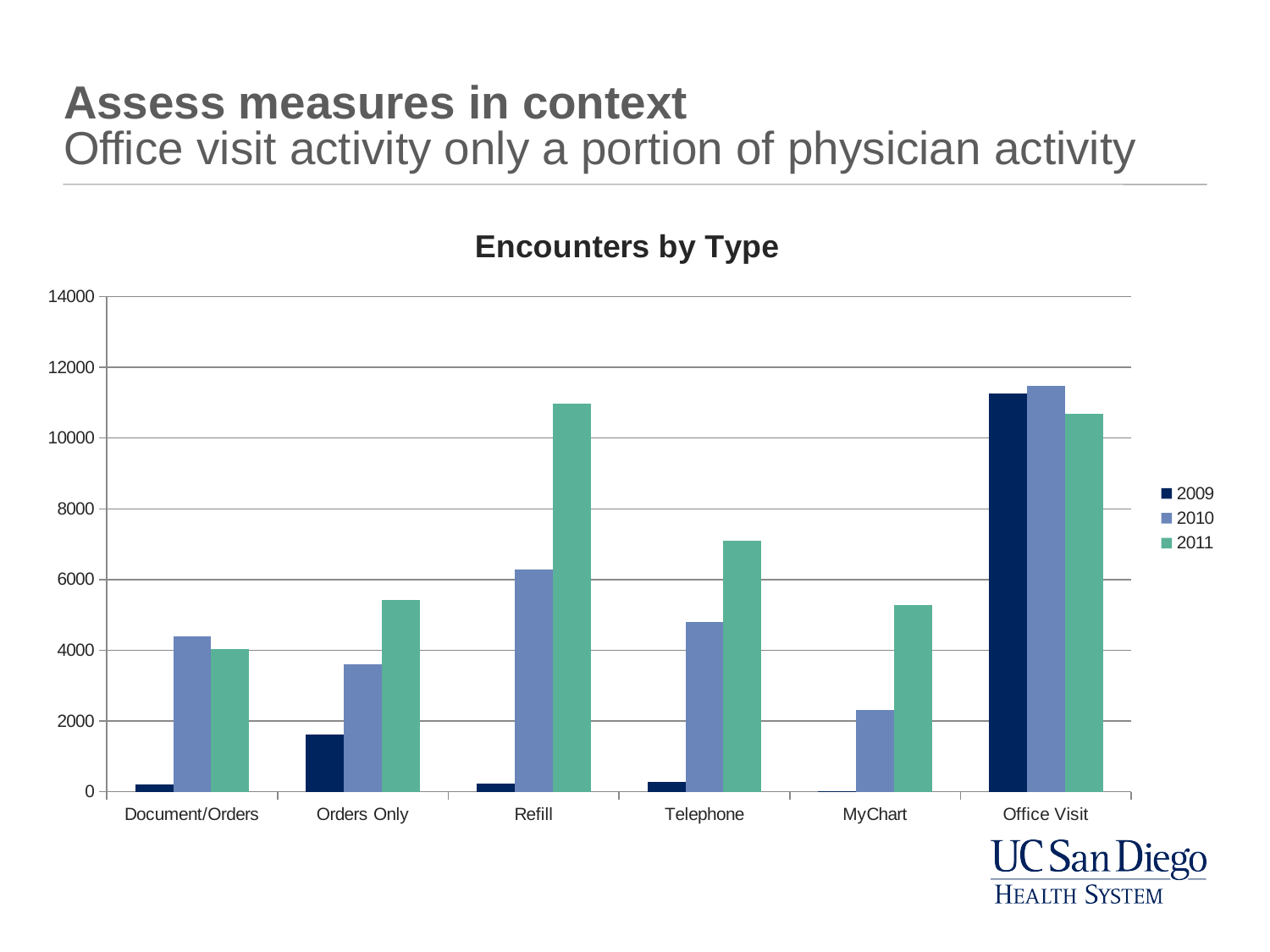
Which encounter type has the highest value for 2009? Office Visit Is the 2011 value for Refill greater or less than 10000? greater What is the title of the chart? Encounters by Type How many series does the legend list in the Encounters by Type chart? 3 Which encounter type has the lowest value for 2011? Document/Orders How many encounter type categories are shown on the x axis? 6 Do the Refill values rise or fall from 2009 to 2011? rise For Orders Only, which year has the larger value, 2010 or 2011? 2011 What kind of chart is shown on the slide? bar chart Which encounter type has the highest value for 2010? Office Visit Is the 2010 value for MyChart greater or less than 2000? greater Is the 2011 value for Telephone greater or less than 8000? less